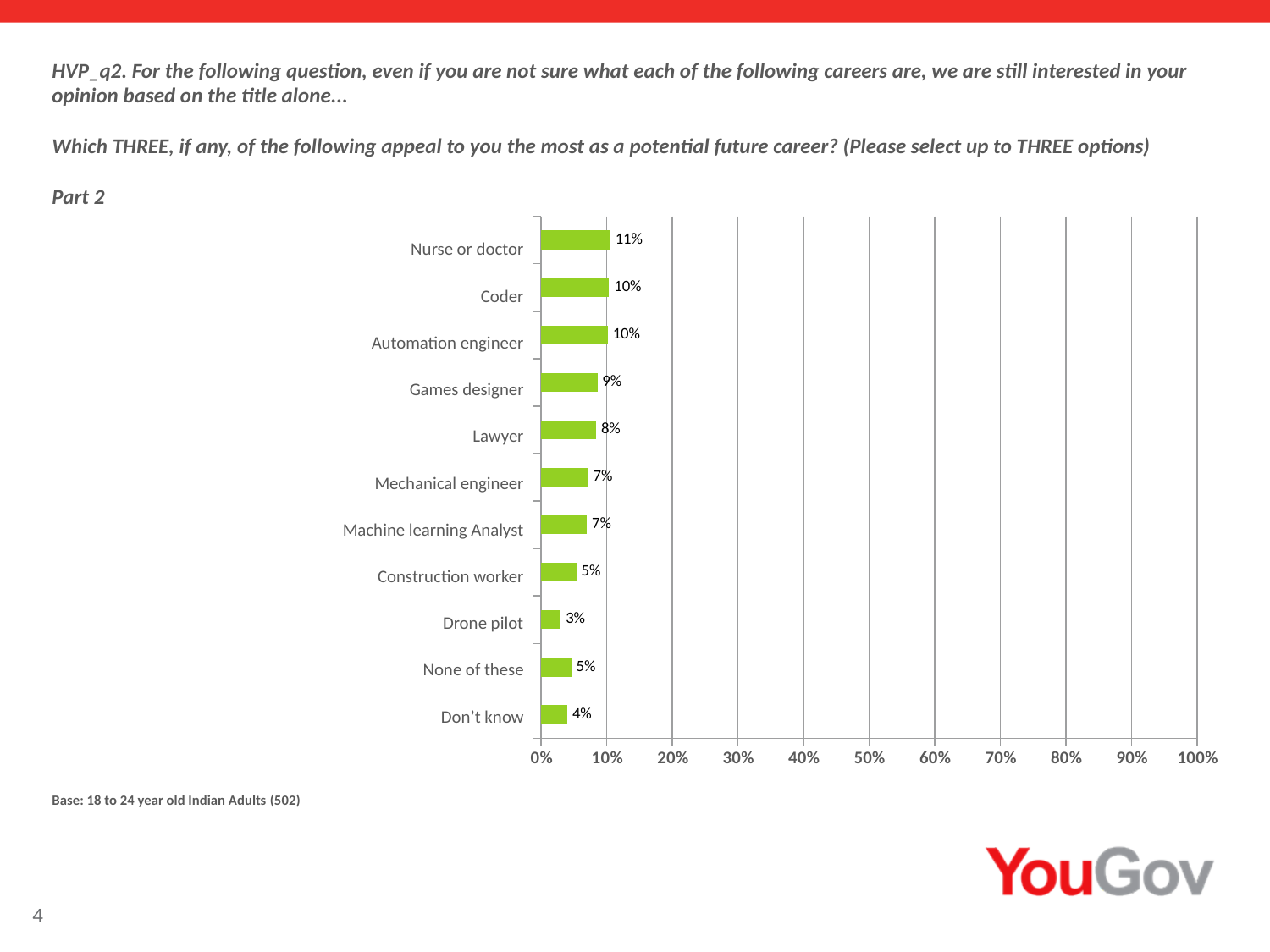
Which is larger, the value for Coder or the value for Construction worker? Coder What is the difference in percentage points between Nurse or doctor and Lawyer? 3 What percentage is shown for Drone pilot? 3% What type of chart is shown on the slide? Bar chart Is the value for Mechanical engineer greater or less than 10%? less What is the maximum value shown on the percentage axis? 100% What is the value shown for Games designer? 9% How many categories are shown on the chart? 11 Which career option has the highest percentage? Nurse or doctor What is the value for Don't know? 4% What percentage of respondents chose Nurse or doctor? 11% Which category has the lowest percentage? Drone pilot